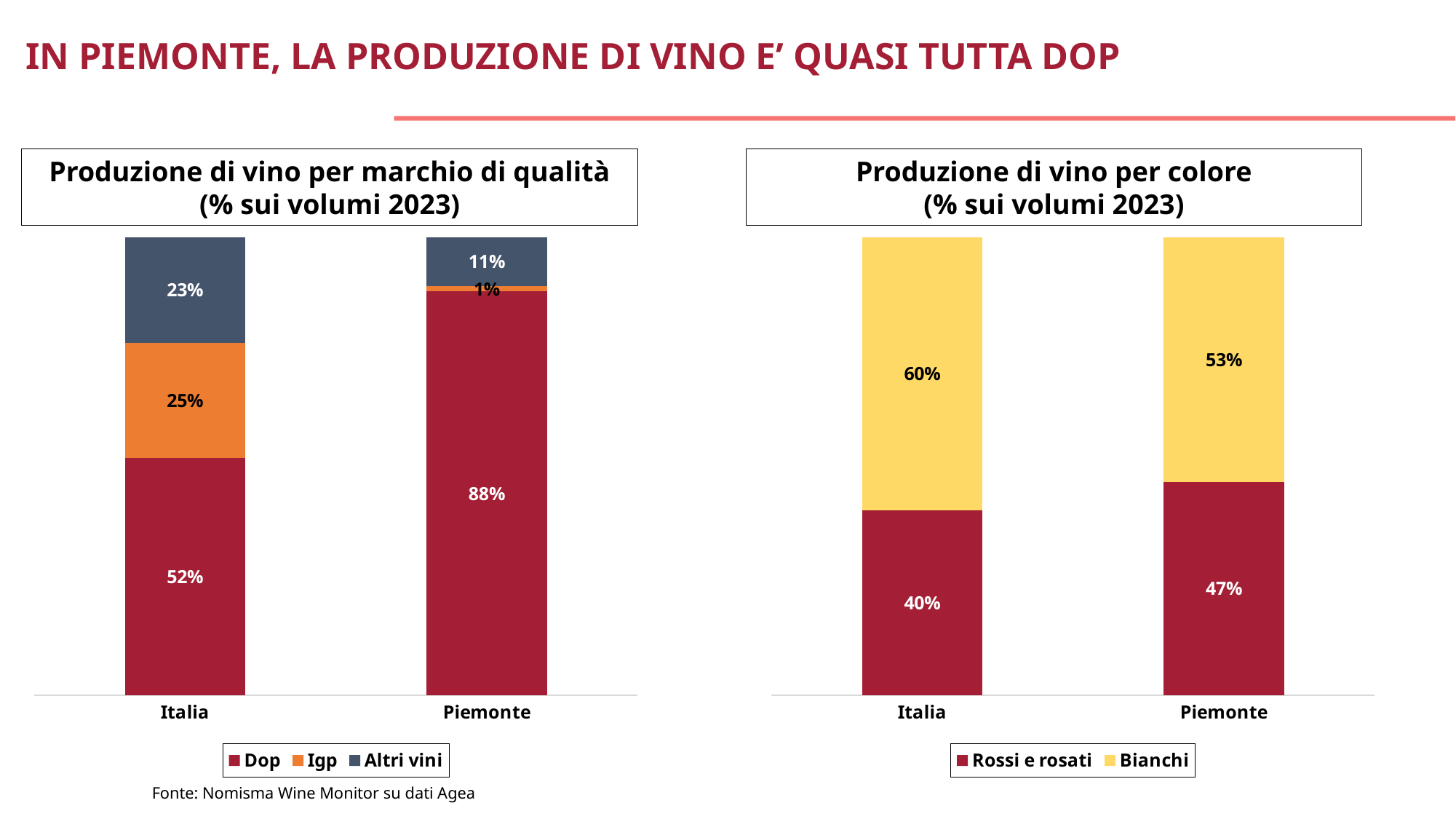
In the chart 'Produzione di vino per marchio di qualità', how many series does the legend list? 3 In the chart 'Produzione di vino per colore', what is the Rossi e rosati share for Italia? 40% In the chart 'Produzione di vino per marchio di qualità', what is the Altri vini share for Piemonte? 11% How many categories are shown on the x axis of the chart 'Produzione di vino per colore'? 2 In the chart 'Produzione di vino per colore', what is the Bianchi share for Piemonte? 53% In the chart 'Produzione di vino per colore', what is the difference between the Bianchi share and the Rossi e rosati share for Italia? 20% In the chart 'Produzione di vino per marchio di qualità', which category has the larger Igp share, Italia or Piemonte? Italia In the chart 'Produzione di vino per marchio di qualità', what is the Dop share for Piemonte? 88% In the chart 'Produzione di vino per marchio di qualità', what is the difference between the Dop share for Piemonte and the Dop share for Italia? 36% In the chart 'Produzione di vino per colore', which category has the larger Rossi e rosati share, Italia or Piemonte? Piemonte What kind of chart is 'Produzione di vino per colore'? Stacked bar chart In the chart 'Produzione di vino per marchio di qualità', what is the Igp share for Italia? 25%